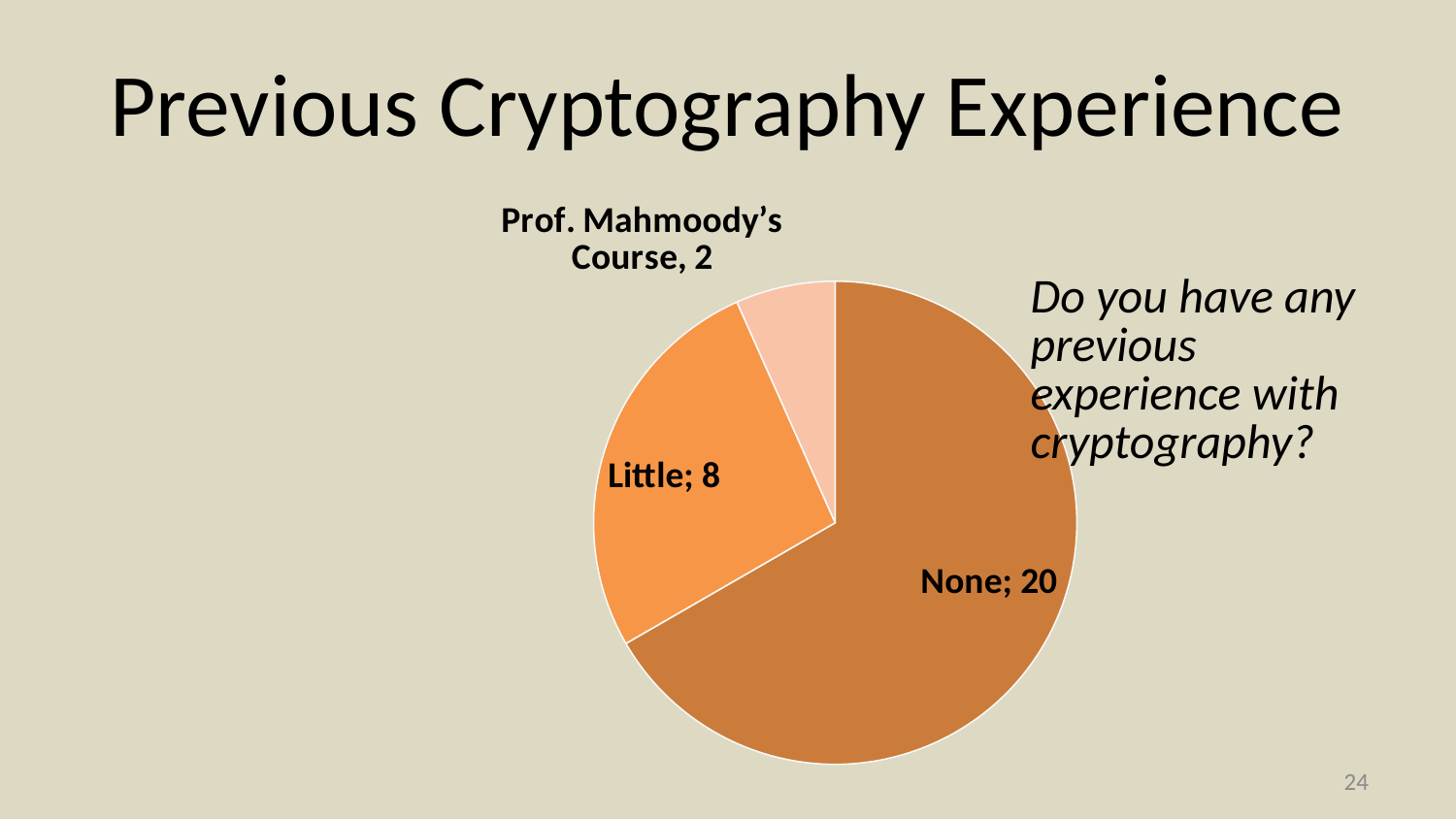
What is the difference between the "None" and "Little" values? 12 What kind of chart is shown on the slide? pie chart Which is larger, the value for "Little" or the value for "Prof. Mahmoody's Course"? Little How many respondents answered "Prof. Mahmoody's Course"? 2 How many categories does the pie chart show? 3 Which category has the smallest slice of the pie? Prof. Mahmoody's Course What is the total of all the slices in the pie chart? 30 What is the title of the slide containing the pie chart? Previous Cryptography Experience Which category has the largest slice of the pie? None How many respondents answered "Little"? 8 What share of the pie does the "Little" slice represent? 26.7% How many respondents answered "None"? 20